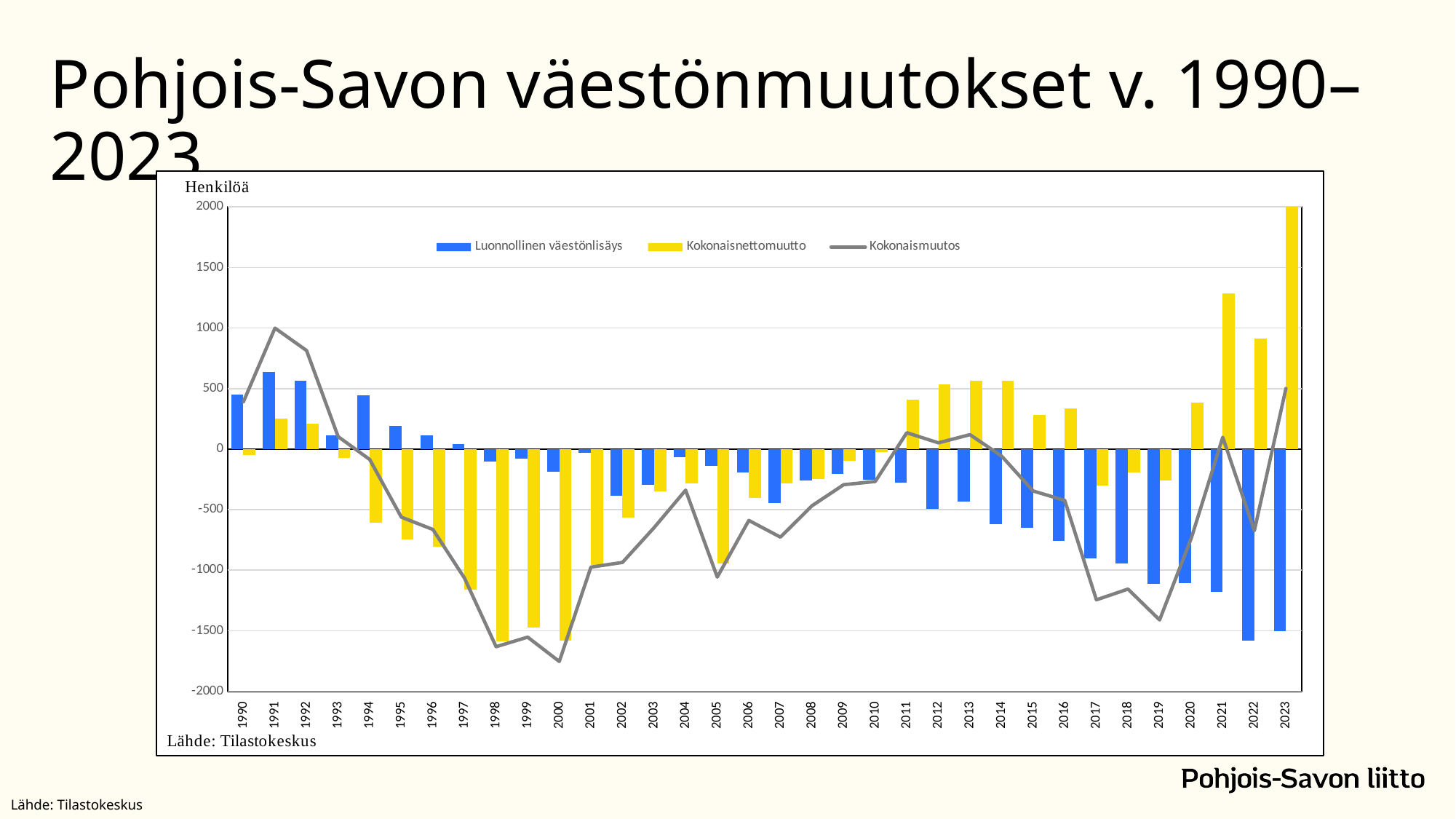
What kind of chart is shown on the slide? A combined bar and line chart Does Luonnollinen väestönlisäys rise or fall from 1991 to 1997? fall Is the value of Kokonaisnettomuutto in 2023 greater or less than 1500? greater In which year does the Kokonaismuutos line reach its lowest point? 2000 In which year is Luonnollinen väestönlisäys highest? 1991 Is the Kokonaismuutos value in 2000 greater or less than -1500? less How many years are shown on the x axis? 34 How many series does the legend list? 3 In which year is Kokonaisnettomuutto highest? 2023 Is the value of Luonnollinen väestönlisäys in 2022 greater or less than -1000? less Which is larger, Kokonaisnettomuutto in 2021 or in 2022? 2021